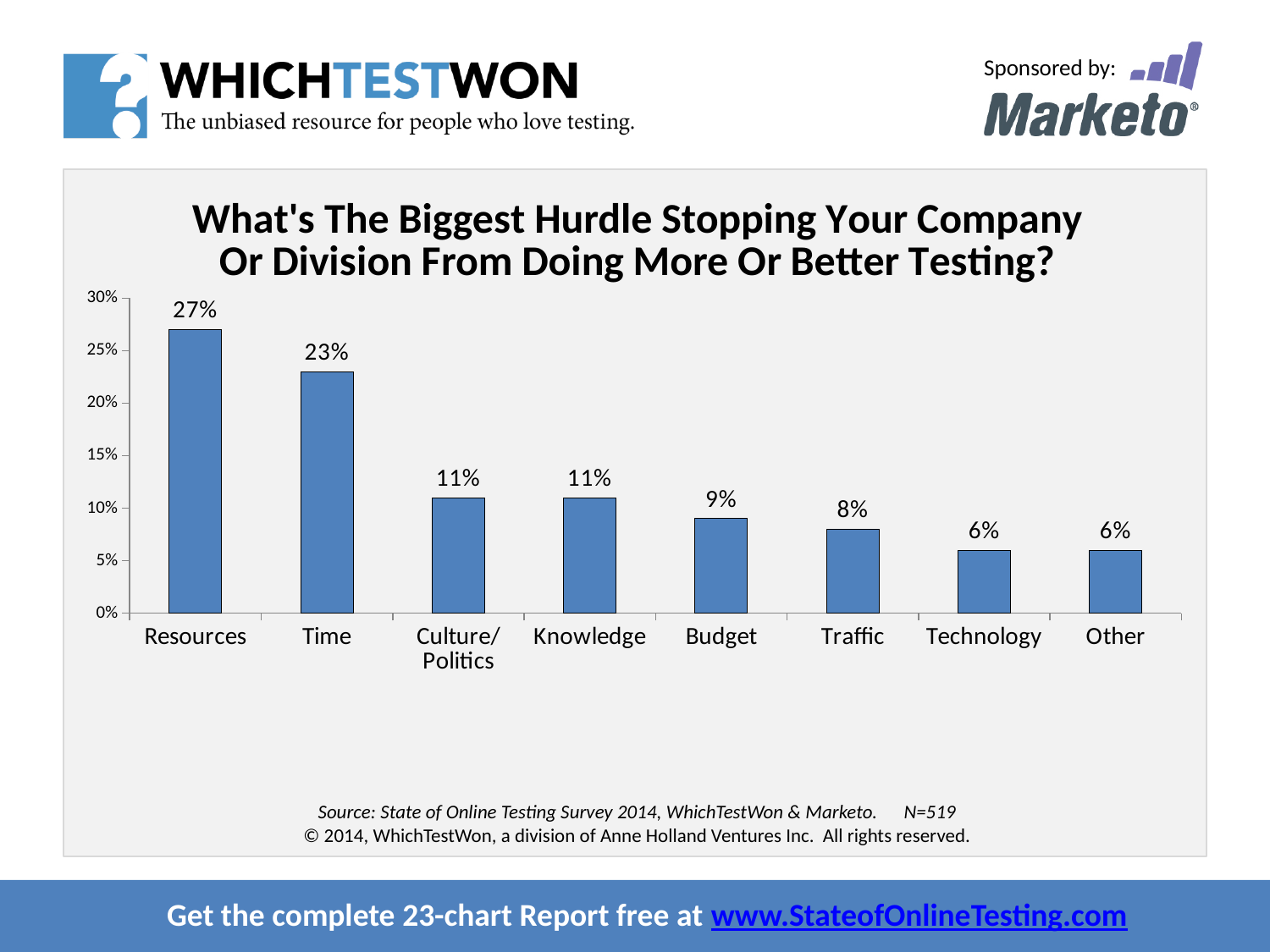
What is the value shown for Budget? 9% Is the value for Time greater or less than 20%? greater What kind of chart is shown on the slide? Bar chart What percentage of respondents cited Resources as the biggest hurdle? 27% Do the values generally rise or fall from left to right along the x axis? Fall Which category has the highest value? Resources Which is larger, the value for Budget or the value for Traffic? Budget What is the title of the chart? What's The Biggest Hurdle Stopping Your Company Or Division From Doing More Or Better Testing? What is the value shown for Traffic? 8% What is the difference between the values for Resources and Time? 4% How many categories are shown on the x axis? 8 What is the difference between the values for Time and Knowledge? 12%